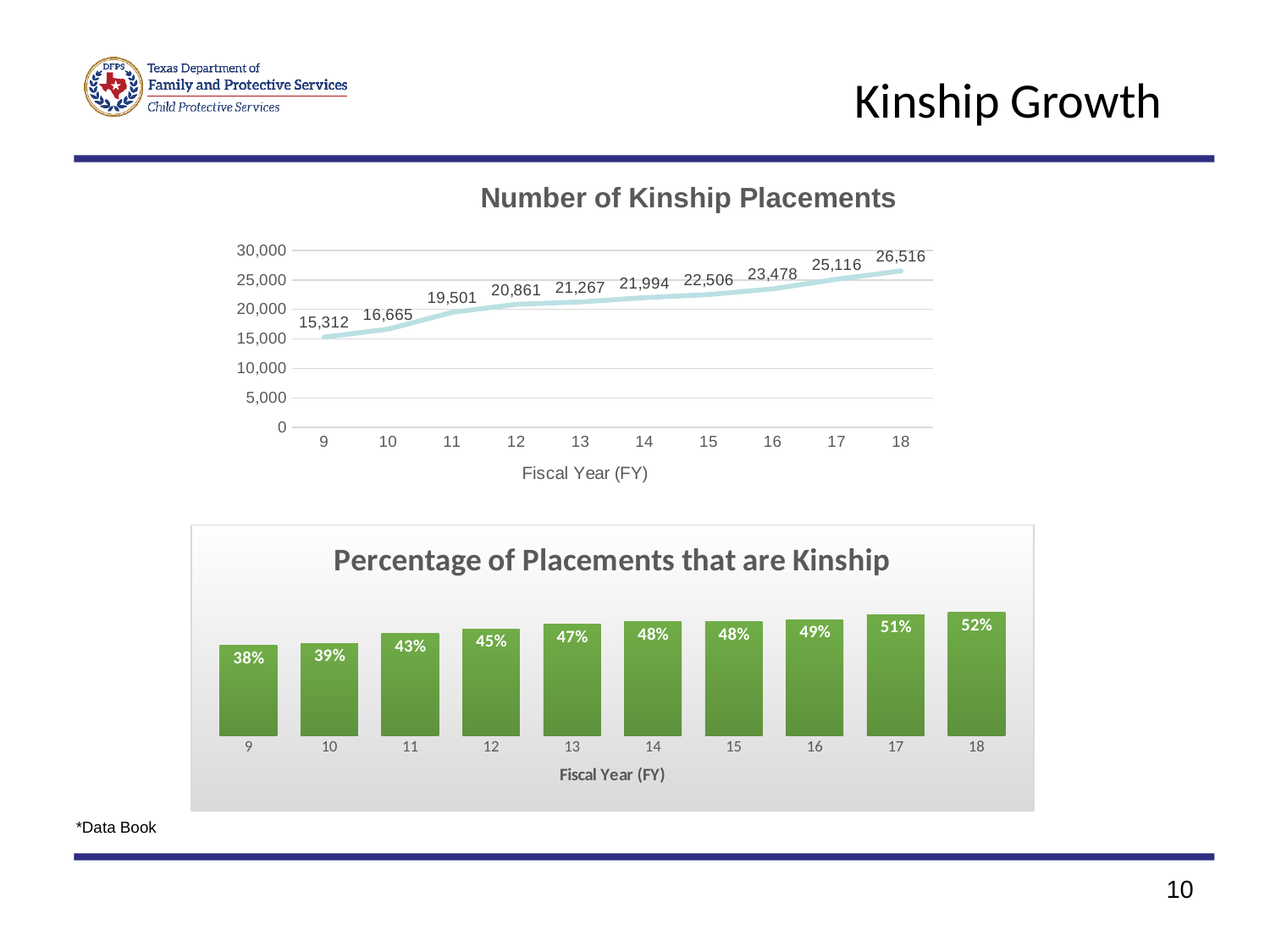
In the 'Number of Kinship Placements' chart, do the values rise or fall from fiscal year 9 to fiscal year 18? rise In the 'Percentage of Placements that are Kinship' chart, which fiscal year has the highest value? 18 How many fiscal years are plotted in the 'Number of Kinship Placements' chart? 10 In the 'Percentage of Placements that are Kinship' chart, which is larger, the value for fiscal year 11 or fiscal year 16? 16 What kind of chart is the 'Number of Kinship Placements' chart? line chart What kind of chart is the 'Percentage of Placements that are Kinship' chart? bar chart In the 'Number of Kinship Placements' chart, which fiscal year has the lowest value? 9 In the 'Number of Kinship Placements' chart, what is the difference between the values for fiscal years 18 and 9? 11,204 In the 'Percentage of Placements that are Kinship' chart, what is the difference between the values for fiscal years 17 and 9? 13% In the 'Percentage of Placements that are Kinship' chart, what is the value for fiscal year 13? 47% In the 'Number of Kinship Placements' chart, what is the value for fiscal year 12? 20,861 In the 'Number of Kinship Placements' chart, what is the value for fiscal year 18? 26,516